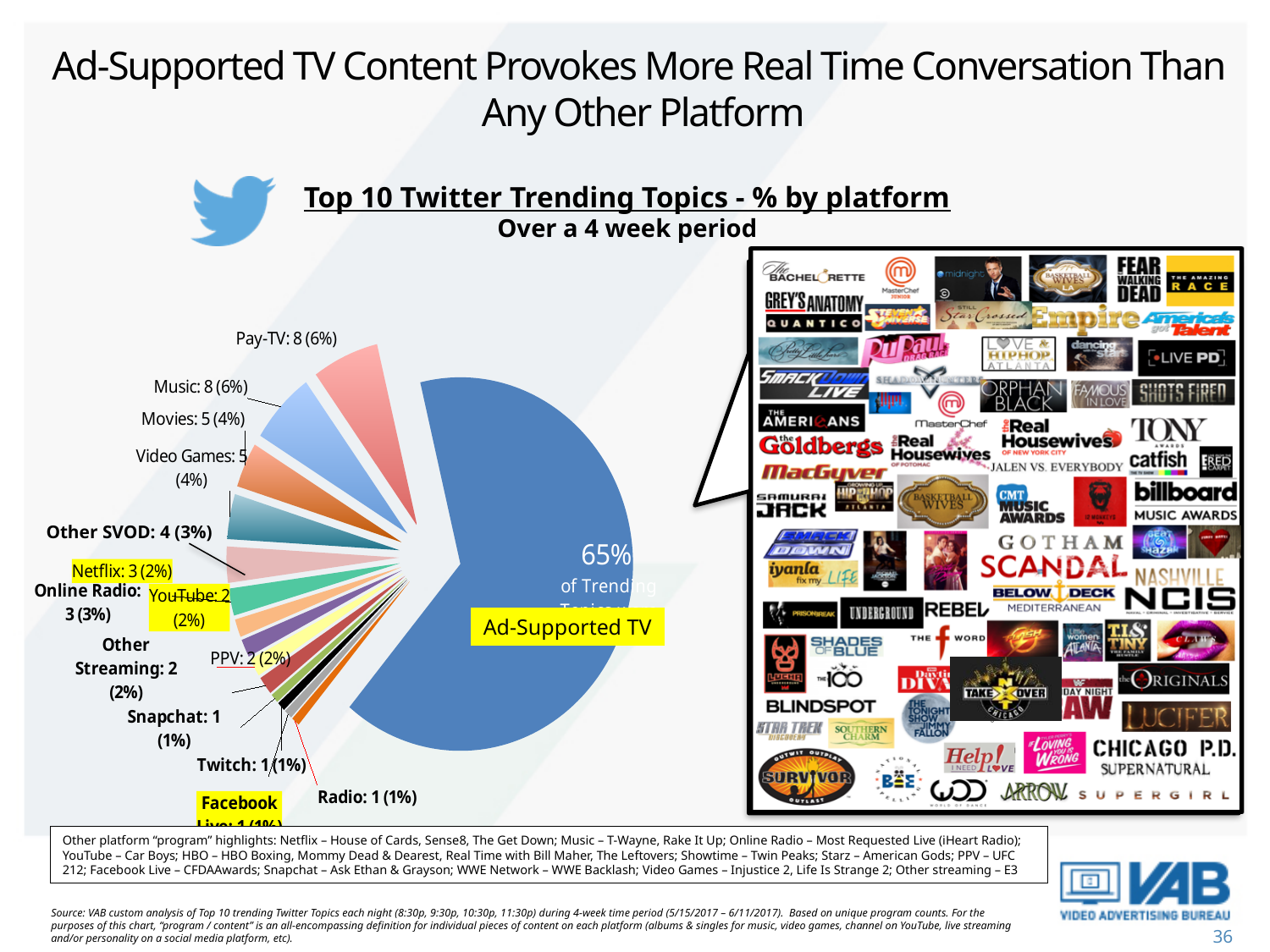
Which has a larger count, Music or Video Games? Music Which platform has the largest slice of the pie? Ad-Supported TV What is the value shown for Snapchat? 1 (1%) What kind of chart is shown on the slide? pie chart How many platform categories are labelled on the pie chart? 15 What share of trending topics does Ad-Supported TV account for? 65% What is the value shown for Pay-TV? 8 (6%) What is the difference in count between Pay-TV and Movies? 3 What percentage is shown for Movies? 4% What percentage is shown for Online Radio? 3% What is the title of the chart? Top 10 Twitter Trending Topics - % by platform What is the value shown for Netflix? 3 (2%)